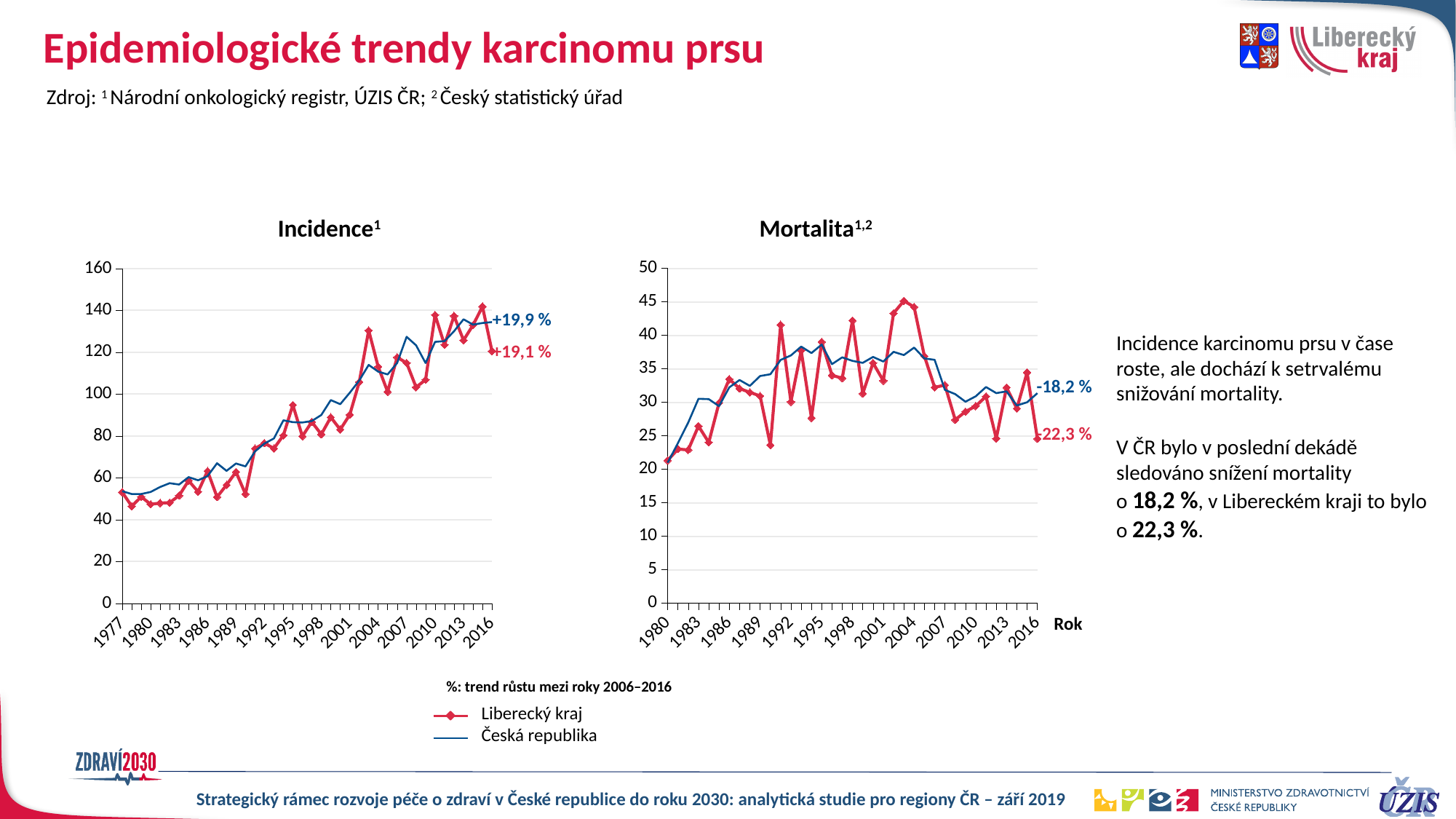
What is the first year shown on the x axis of the Incidence chart? 1977 What kind of chart is the Incidence chart? line chart On the Mortalita chart, what trend between 2006 and 2016 is printed for Česká republika? -18,2 % On the Incidence chart, what growth trend between 2006 and 2016 is printed for Česká republika? +19,9 % On the Incidence chart, do the values for Česká republika generally rise or fall from 1977 to 2016? rise On the Mortalita chart, is the value for Liberecký kraj in 2016 greater or less than 30? less On the Incidence chart, is the value for Liberecký kraj in 2016 greater or less than 100? greater How many series does the legend list for the charts? 2 On the Incidence chart, which series has the larger printed growth trend for 2006–2016, Liberecký kraj or Česká republika? Česká republika On the Incidence chart, what growth trend between 2006 and 2016 is printed for Liberecký kraj? +19,1 % On the Mortalita chart, what is the difference between the printed 2006–2016 trends for Liberecký kraj and Česká republika? 4,1 % On the Mortalita chart, what trend between 2006 and 2016 is printed for Liberecký kraj? -22,3 %